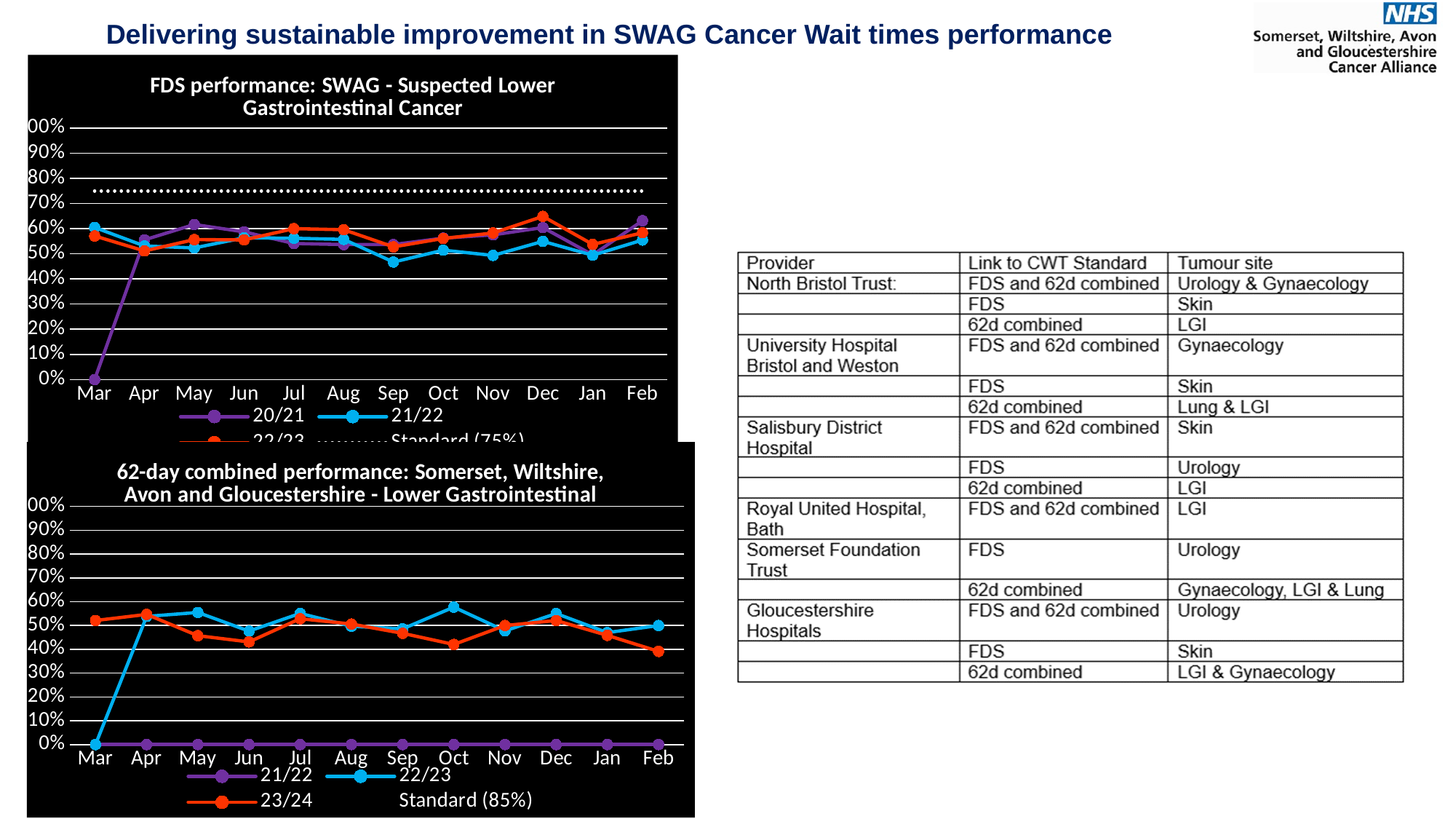
In the bottom chart, '62-day combined performance', does the 23/24 line rise or fall from Dec to Feb? Fall In the top chart, 'FDS performance', is the value for 22/23 in Dec greater or less than 60%? greater In the top chart, 'FDS performance', is the value for 21/22 in Sep greater or less than 50%? less How many entries does the legend of the top chart, 'FDS performance', list? 4 In the bottom chart, '62-day combined performance', is the value for 23/24 in Jun greater or less than 50%? less How many months are shown on the x axis of the bottom chart, '62-day combined performance'? 12 What kind of chart is the top chart, 'FDS performance: SWAG - Suspected Lower Gastrointestinal Cancer'? Line chart In the bottom chart, '62-day combined performance', what is the value for 21/22 in Feb? 0% What standard percentage is named in the legend of the bottom chart, '62-day combined performance'? Standard (85%) In the top chart, 'FDS performance', what is the value for 20/21 in Mar? 0% In the top chart, 'FDS performance', which is larger in Dec: 22/23 or 21/22? 22/23 In the bottom chart, '62-day combined performance', which is larger in Oct: 22/23 or 23/24? 22/23